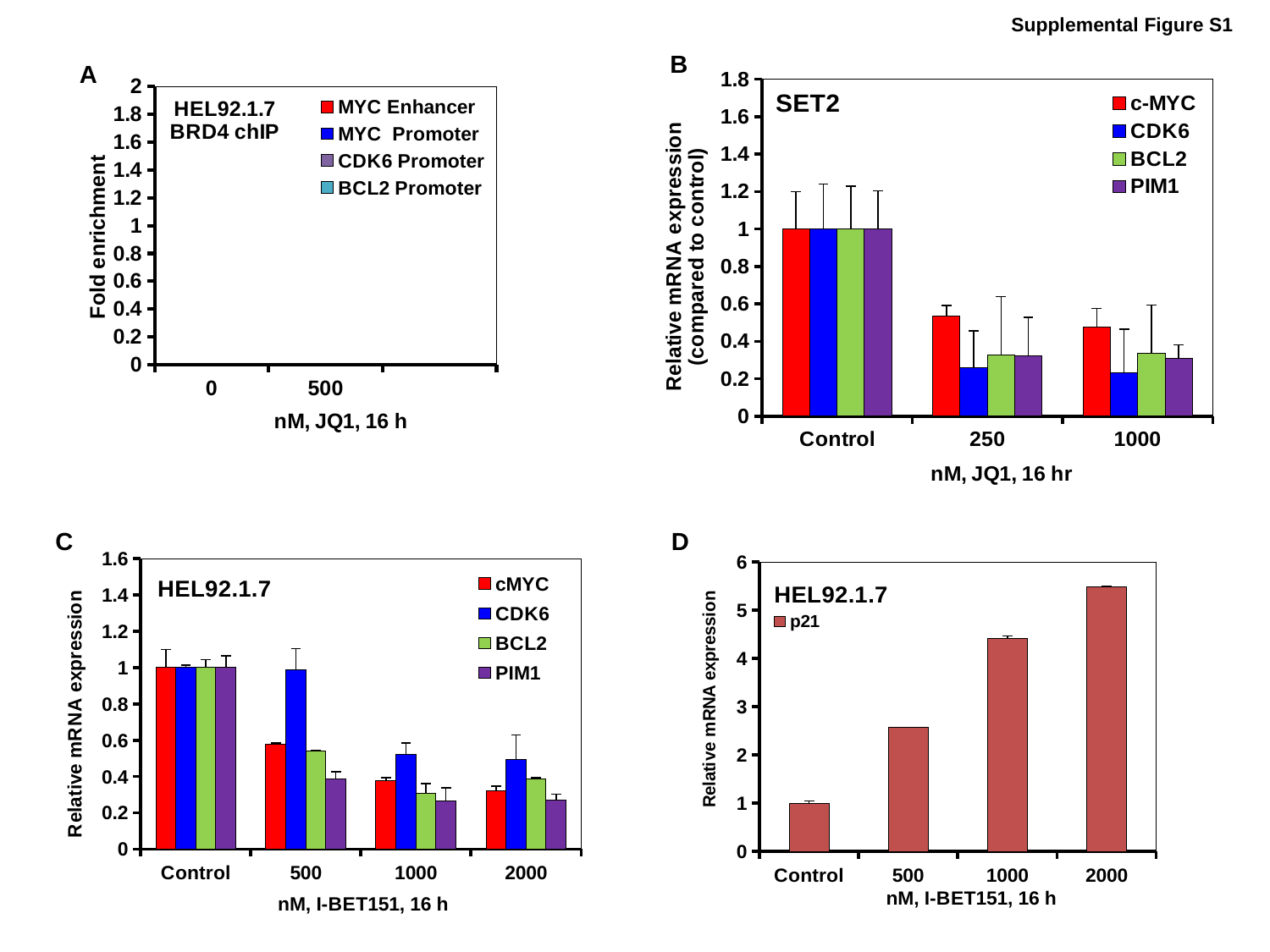
In chart B (SET2), how many series does the legend list? 4 In chart D (HEL92.1.7, p21), how many concentration categories are shown on the x axis? 4 In chart D (HEL92.1.7, p21), is the value for 1000 nM greater or less than 4? greater In chart B (SET2), is the value for c-MYC at 250 nM greater or less than 0.4? greater In chart C (HEL92.1.7, I-BET151), which series has the highest value at 500 nM? CDK6 In chart D (HEL92.1.7, p21), which concentration has the highest relative mRNA expression? 2000 In chart B (SET2), is the value for CDK6 at 1000 nM greater or less than 0.4? less In chart C (HEL92.1.7, I-BET151), do the cMYC values rise or fall as the concentration increases along the x axis? fall In chart D (HEL92.1.7, p21), which concentration has the lowest relative mRNA expression? Control In chart A (HEL92.1.7 BRD4 chIP), how many series does the legend list? 4 What kind of chart is chart D (HEL92.1.7, p21)? bar chart In chart D (HEL92.1.7, p21), do the values rise or fall as the I-BET151 concentration increases along the x axis? rise